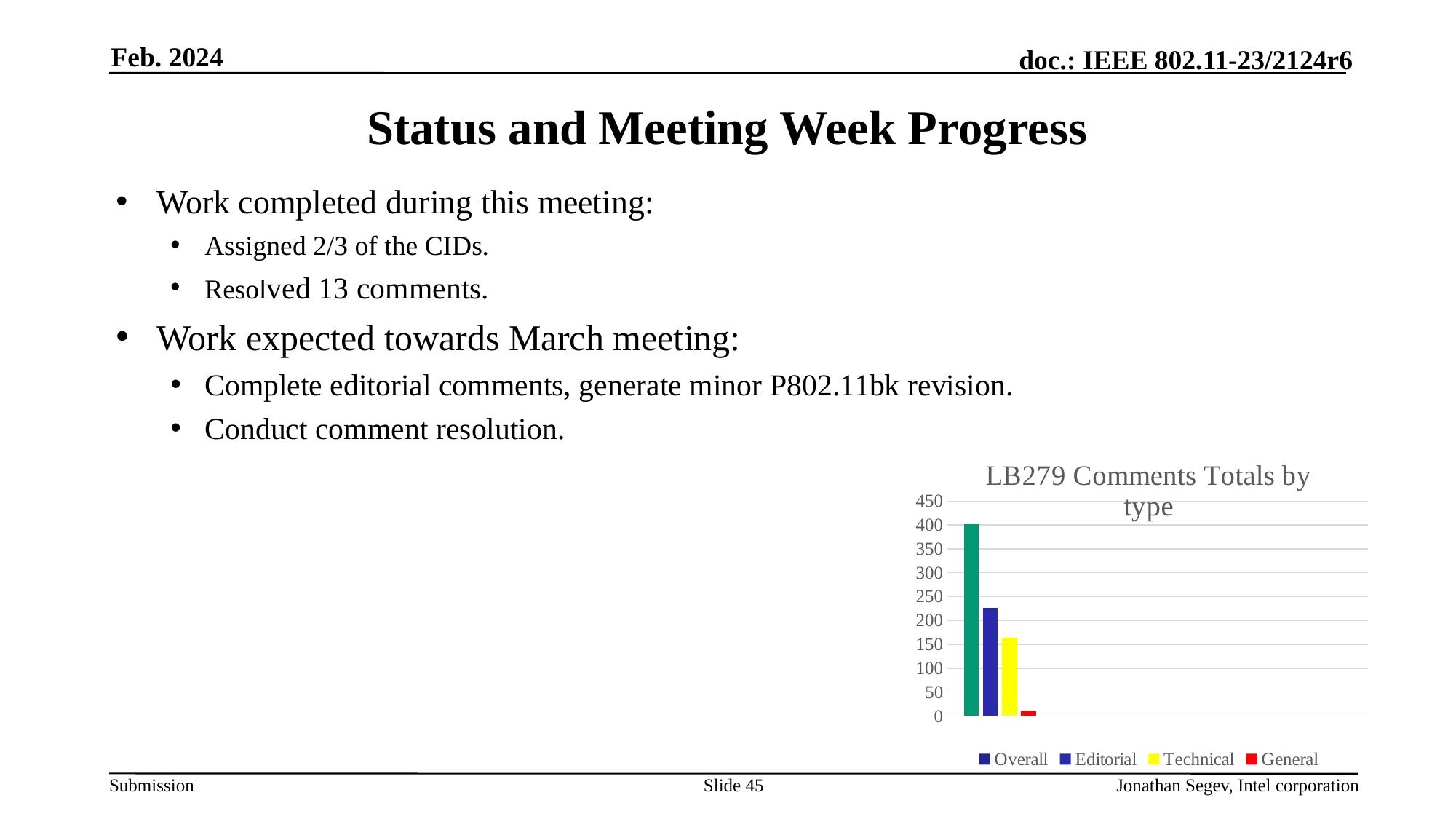
Is the value for General greater or less than 50? less Which series has the shortest bar in the chart? General Is the value for Overall greater or less than 350? greater What is the highest value shown on the chart's vertical axis? 450 What type of chart is shown on the slide? bar chart How many series does the chart legend list? 4 Is the value for Editorial greater or less than 200? greater Which series has the tallest bar in the chart? Overall What is the title of the chart on the slide? LB279 Comments Totals by type Which is larger, the Editorial bar or the Technical bar? Editorial